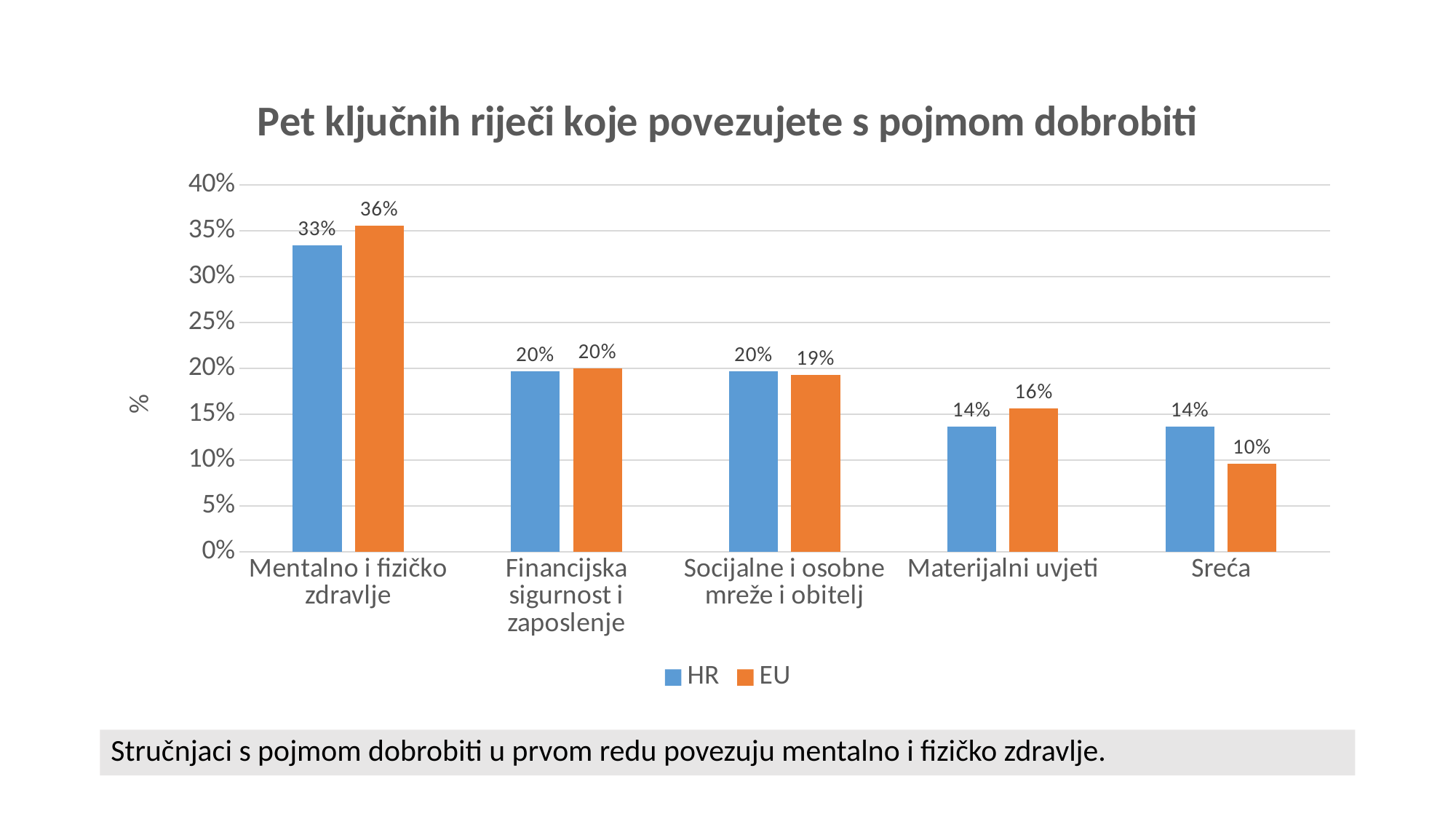
For Materijalni uvjeti, which is larger, the HR value or the EU value? EU What is the EU value for Sreća? 10% Which category has the highest EU value? Mentalno i fizičko zdravlje What is the difference between the EU and HR values for Mentalno i fizičko zdravlje? 3% What is the EU value for Materijalni uvjeti? 16% What kind of chart is shown on the slide? Bar chart How many series does the legend list? 2 What is the HR value for Mentalno i fizičko zdravlje? 33% What is the difference between the HR and EU values for Sreća? 4% How many categories are shown on the x axis? 5 Which category has the lowest EU value? Sreća For Sreća, which is larger, the HR value or the EU value? HR